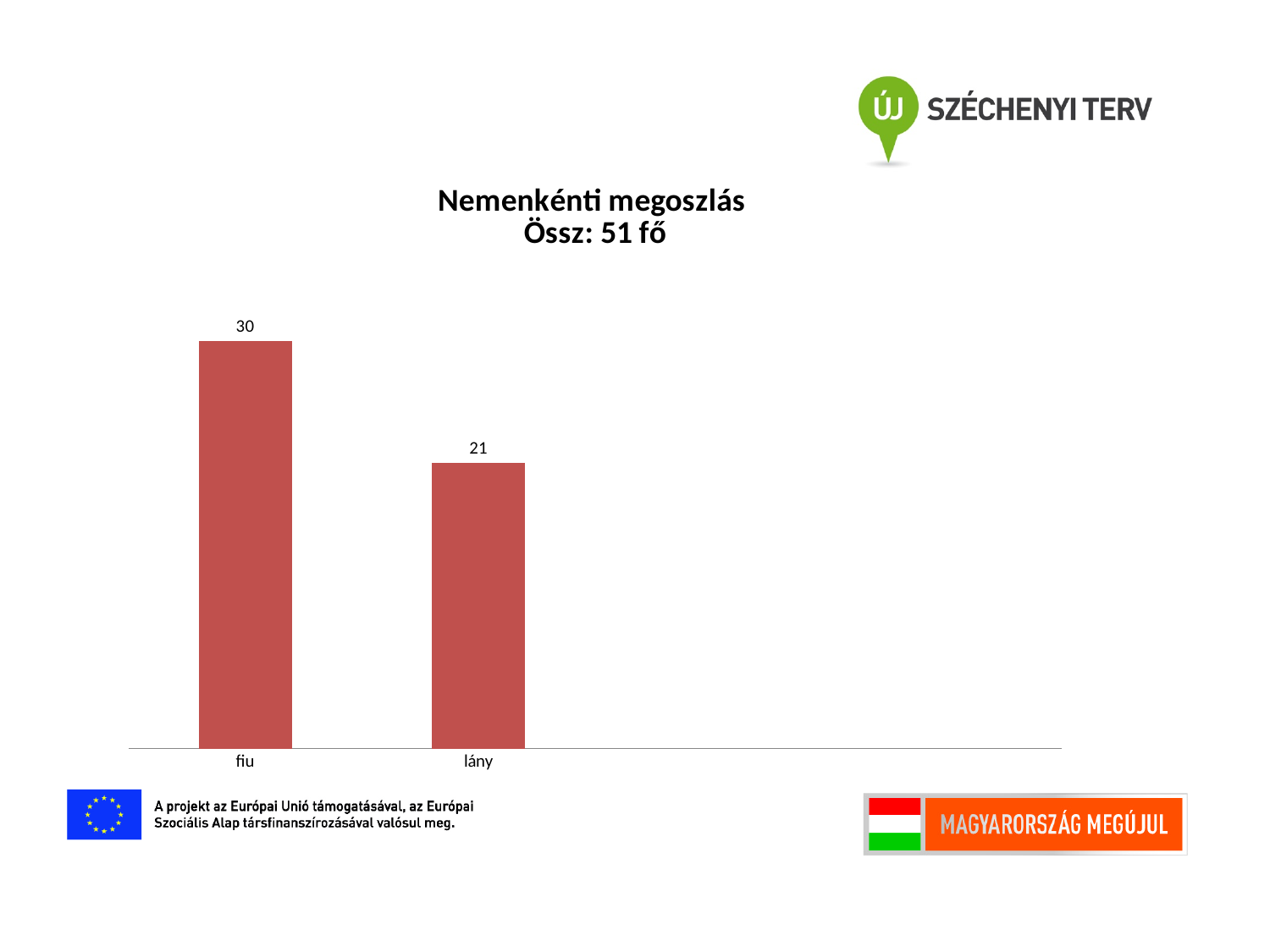
What colour are the bars in the chart? red What is the total of the two values shown in the chart? 51 Which is larger, the value for fiu or the value for lány? fiu Which category has the lowest value? lány What is the difference between the values for fiu and lány? 9 What kind of chart is shown on the slide? bar chart What is the title of the chart? Nemenkénti megoszlás Össz: 51 fő Which category has the highest value? fiu How many categories are shown in the chart? 2 What is the value for lány? 21 What is the value for fiu? 30